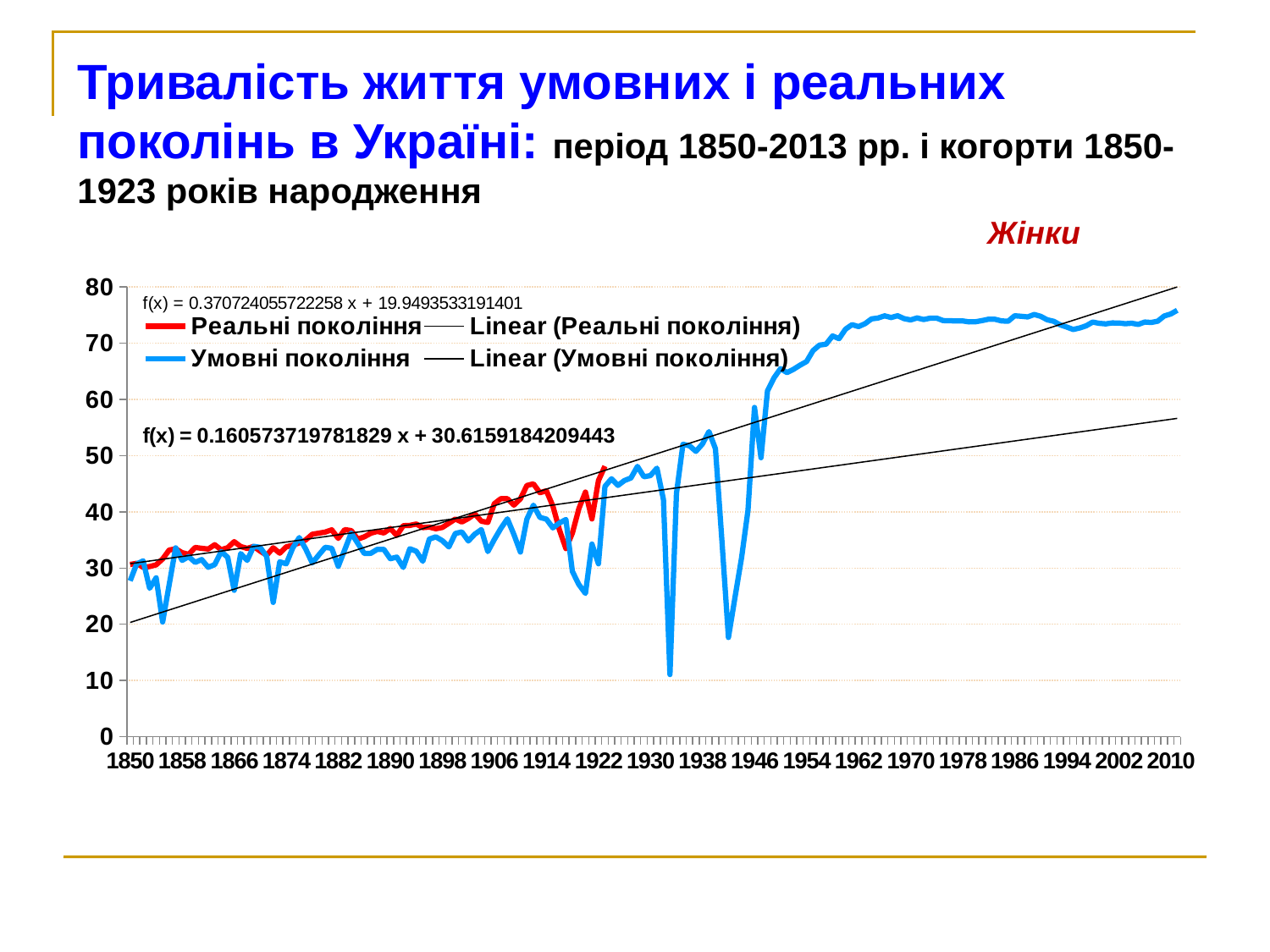
Overall, does the Умовні покоління series rise or fall from 1850 to 2010? rise What label appears in red italics above the chart, to the right? Жінки At 1922, which series has the larger value, Реальні покоління or Умовні покоління? Реальні покоління Is the value for Умовні покоління at its deepest dip between 1930 and 1938 greater or less than 20? less How many year labels are shown on the x axis? 21 What kind of chart is shown on the slide? line chart Which series is drawn in red? Реальні покоління Between which two labelled years on the x axis does Умовні покоління reach its lowest value? 1930 and 1938 How many entries does the chart legend list? 4 Is the value for Реальні покоління at 1922 greater or less than 40? greater Is the value for Умовні покоління in 2010 greater or less than 70? greater